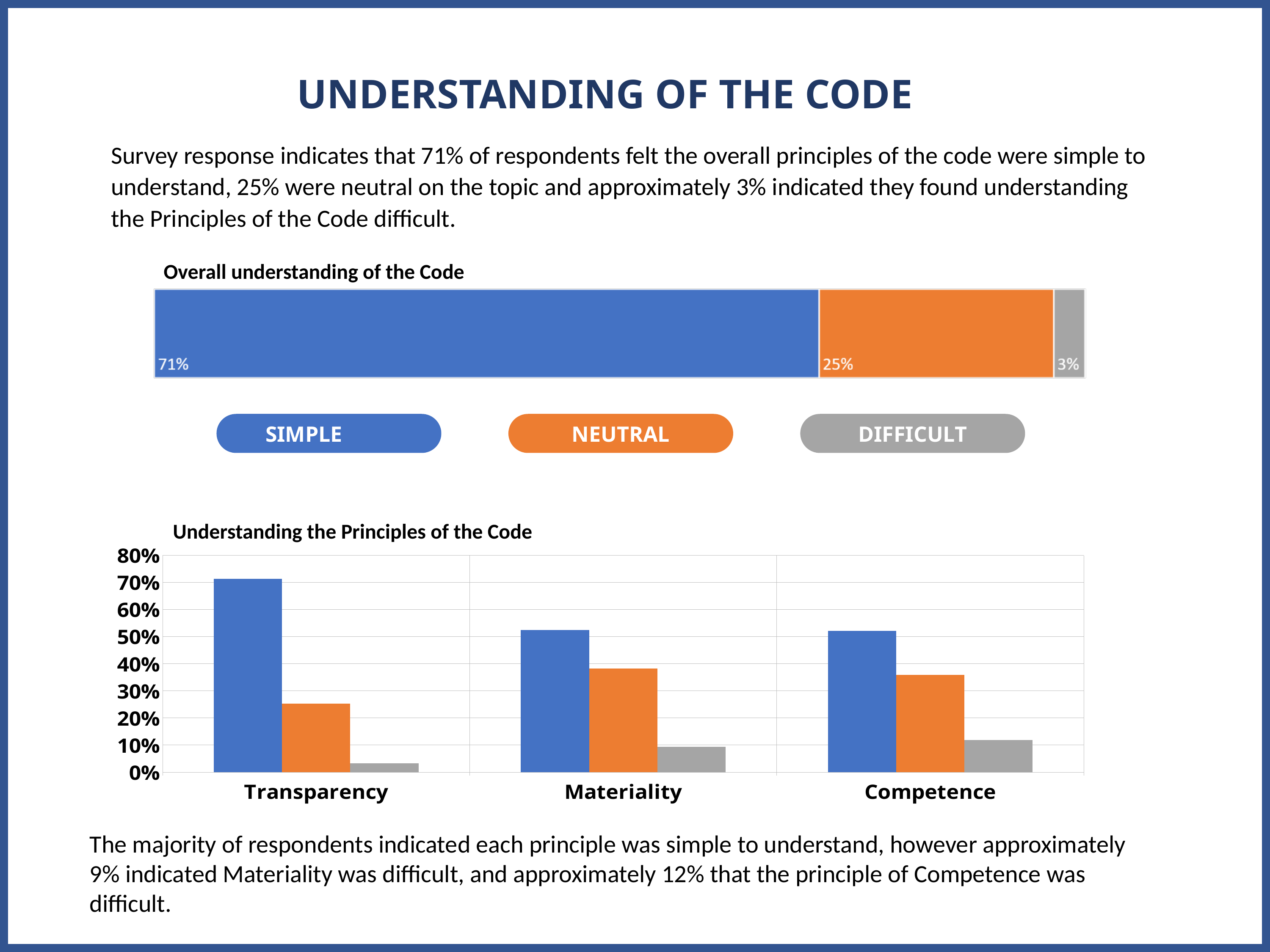
What kind of chart is 'Understanding the Principles of the Code'? Bar chart In the 'Overall understanding of the Code' chart, what is the difference between the Simple and Neutral percentages? 46% In the 'Understanding the Principles of the Code' chart, how many principles are shown on the x axis? 3 In the 'Overall understanding of the Code' chart, what percentage of respondents found the code difficult? 3% In the 'Understanding the Principles of the Code' chart, which is larger for Materiality: the Simple bar or the Neutral bar? Simple In the 'Understanding the Principles of the Code' chart, is the Difficult value for Transparency greater or less than 10%? less In the 'Overall understanding of the Code' chart, what percentage of respondents found the code simple? 71% In the 'Overall understanding of the Code' chart, which response category has the largest share? Simple In the 'Overall understanding of the Code' chart, how many segments make up the stacked bar? 3 In the 'Understanding the Principles of the Code' chart, which principle has the highest Simple value? Transparency In the 'Overall understanding of the Code' chart, what percentage of respondents were neutral? 25% In the 'Understanding the Principles of the Code' chart, is the Simple value for Transparency greater or less than 60%? greater